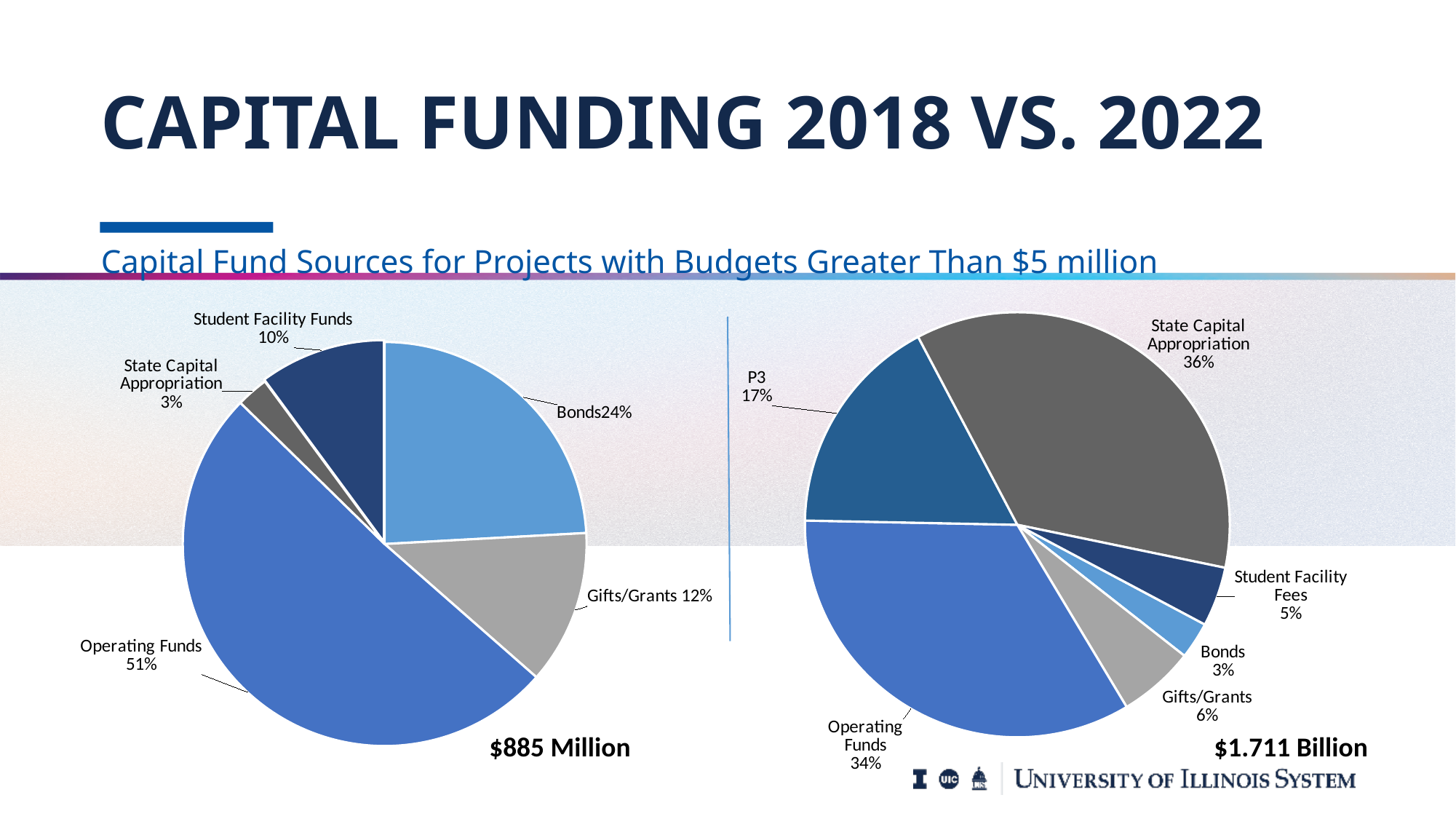
In the left pie chart ($885 Million), what share is Bonds? 24% In the right pie chart ($1.711 Billion), which is larger: Gifts/Grants or Student Facility Fees? Gifts/Grants In the left pie chart ($885 Million), which category has the largest slice? Operating Funds In the right pie chart ($1.711 Billion), what share is State Capital Appropriation? 36% In the left pie chart ($885 Million), what share is Operating Funds? 51% What is the difference in percentage points between Operating Funds in the left pie chart (51%) and Operating Funds in the right pie chart (34%)? 17 In the left pie chart ($885 Million), which category has the smallest slice? State Capital Appropriation In the right pie chart ($1.711 Billion), what share is P3? 17% How many categories are shown in the left pie chart ($885 Million)? 5 In the right pie chart ($1.711 Billion), which category has the smallest slice? Bonds What type of chart is used on this slide? Pie chart How many categories are shown in the right pie chart ($1.711 Billion)? 6